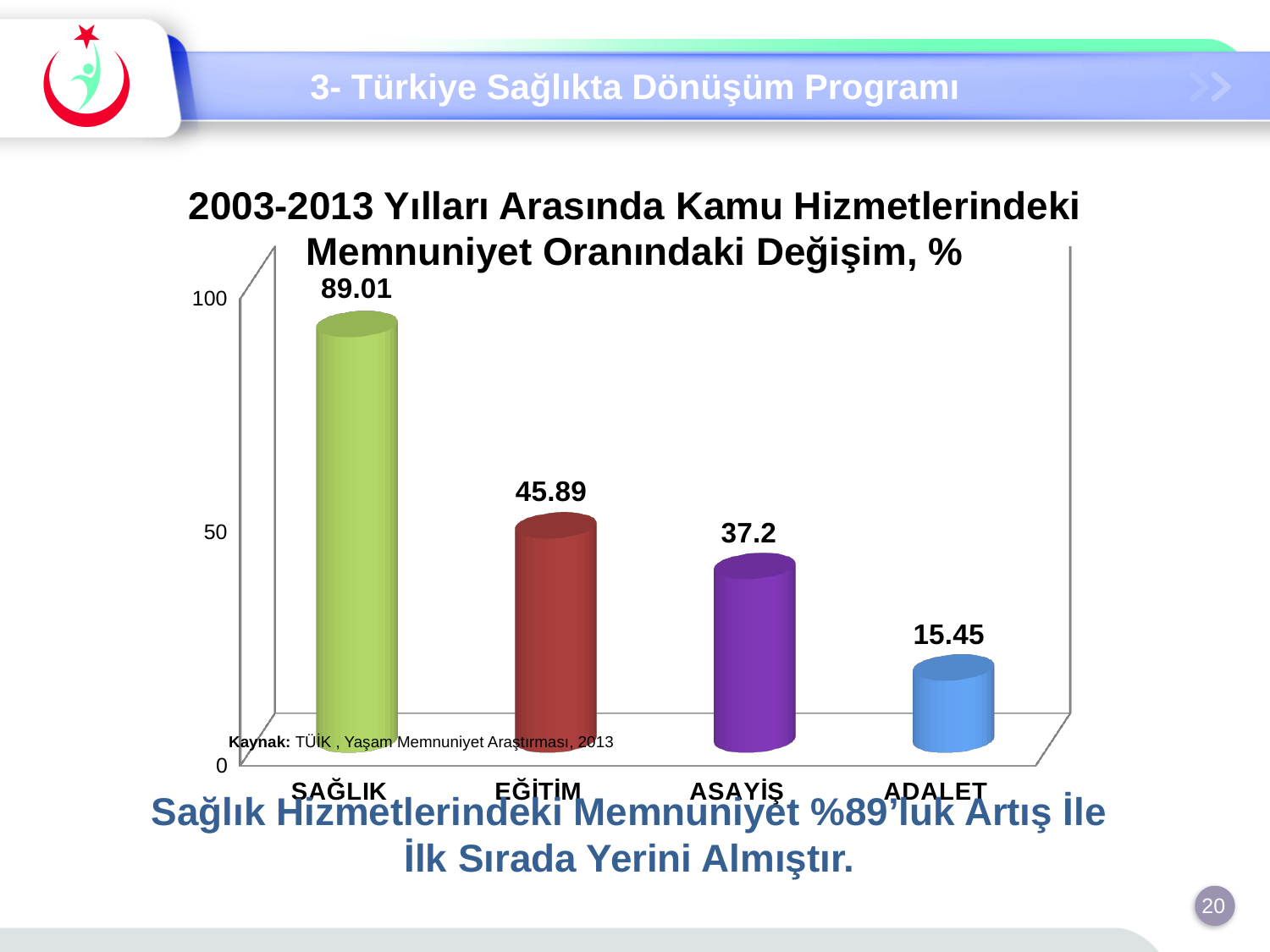
What is the value for EĞİTİM? 45.89 Is the value for EĞİTİM greater or less than 50? less Which category has the highest value? SAĞLIK Which category has the lowest value? ADALET How many categories are shown in the chart? 4 What is the value for ASAYİŞ? 37.2 Which is larger, the value for ASAYİŞ or the value for ADALET? ASAYİŞ What is the value for ADALET? 15.45 What is the value for SAĞLIK? 89.01 What kind of chart is shown on the slide? bar chart What is the title of the chart? 2003-2013 Yılları Arasında Kamu Hizmetlerindeki Memnuniyet Oranındaki Değişim, % What is the difference between the values for SAĞLIK and EĞİTİM? 43.12